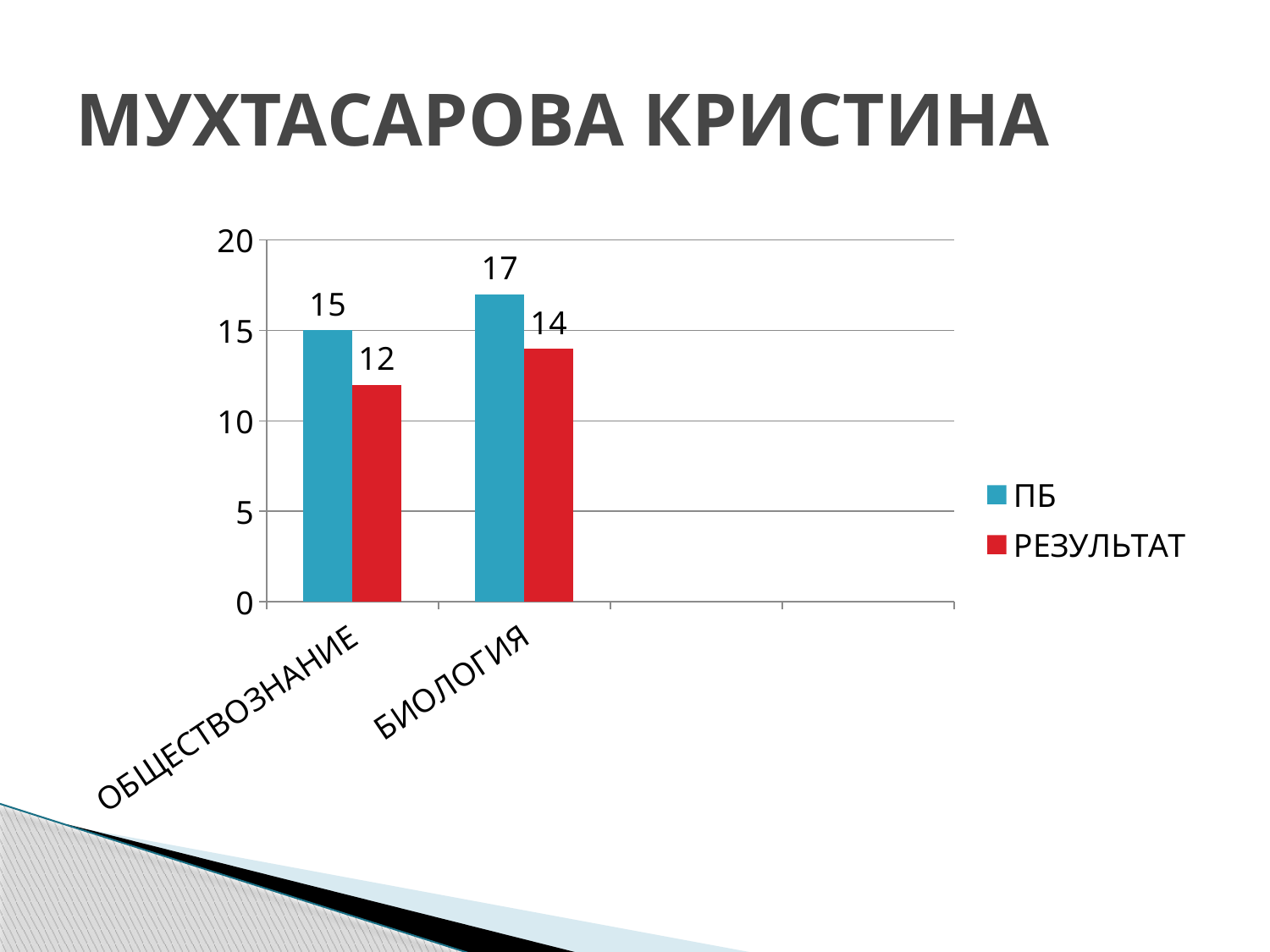
What kind of chart is shown on the slide? Bar chart What is the РЕЗУЛЬТАТ value for ОБЩЕСТВОЗНАНИЕ? 12 What is the difference between the ПБ and РЕЗУЛЬТАТ values for БИОЛОГИЯ? 3 How many categories are shown on the x axis? 2 Which category has the lower РЕЗУЛЬТАТ value? ОБЩЕСТВОЗНАНИЕ What is the РЕЗУЛЬТАТ value for БИОЛОГИЯ? 14 What is the ПБ value for БИОЛОГИЯ? 17 What is the difference between the ПБ and РЕЗУЛЬТАТ values for ОБЩЕСТВОЗНАНИЕ? 3 How many series does the legend list? 2 For БИОЛОГИЯ, which is larger: ПБ or РЕЗУЛЬТАТ? ПБ What is the ПБ value for ОБЩЕСТВОЗНАНИЕ? 15 Which category has the higher ПБ value? БИОЛОГИЯ